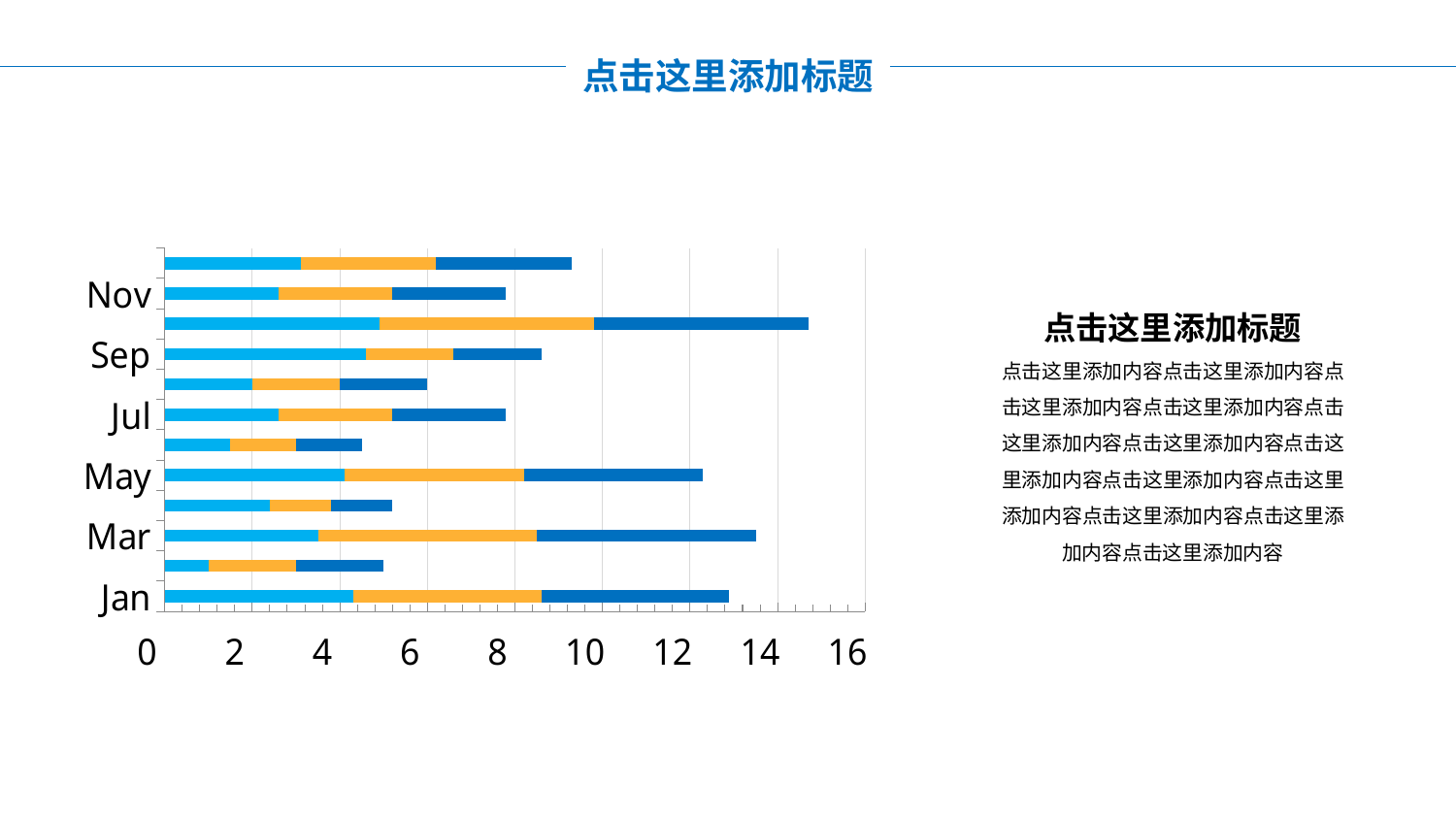
What kind of chart is shown on the slide? stacked bar chart How many colored segments (series) make up each bar in the chart? 3 Is the total value of the bar for Jul greater or less than 10? less Is the total value of the bar for May greater or less than 10? greater Which bar is longer in total, Jan or Jul? Jan Is the total value of the bar for Nov greater or less than 10? less How many bars are plotted in the chart? 12 Which bar is longer in total, Mar or Sep? Mar What is the highest value shown on the x axis of the chart? 16